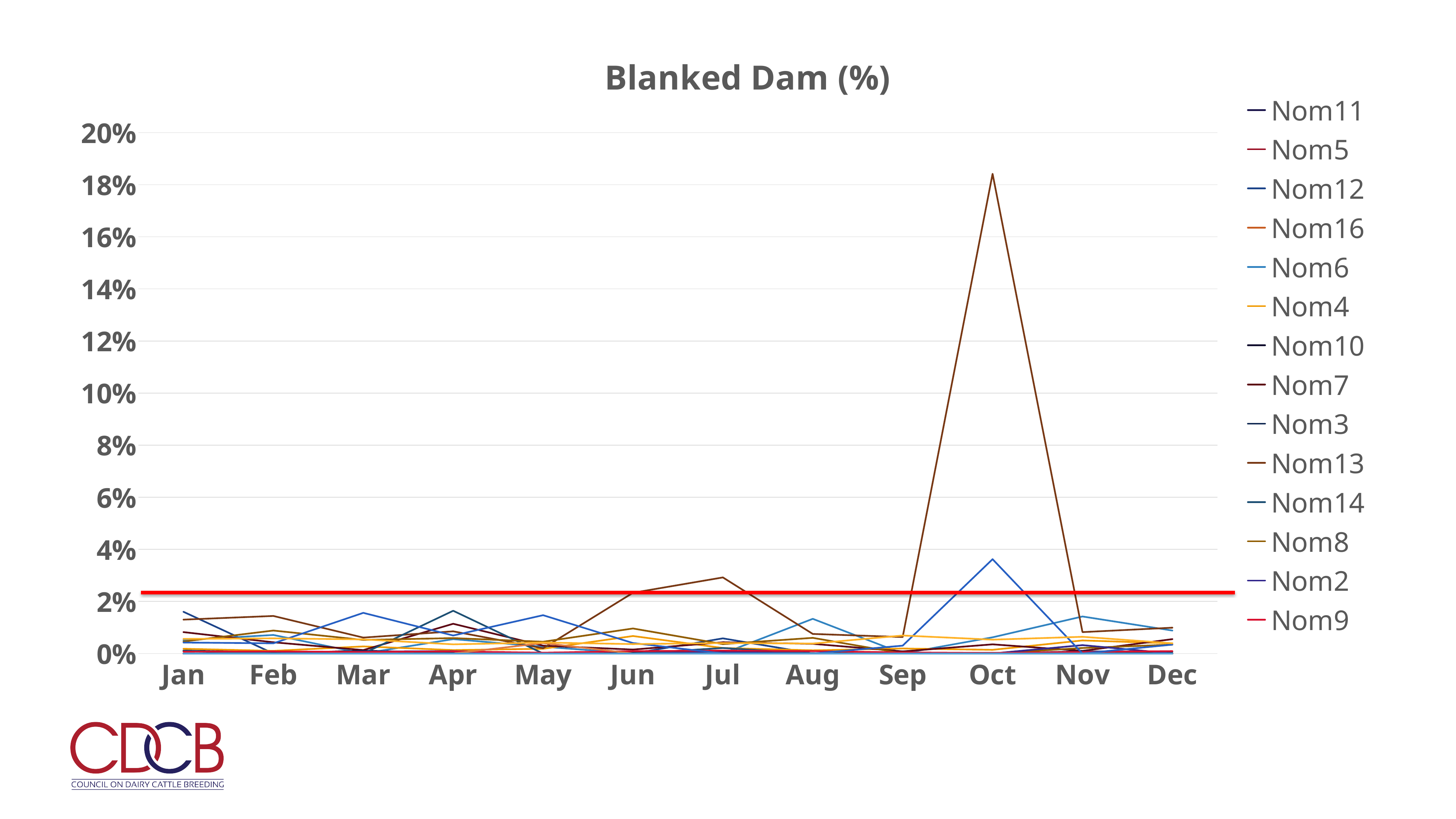
Which series is listed first in the legend? Nom11 Which series reaches the highest value on the chart? Nom13 How many series does the legend list? 14 How many months are shown along the x axis? 12 In Oct, which is larger, the value for Nom13 or the value for Nom12? Nom13 Is the value for Nom13 in Oct greater or less than 16%? greater In which month does Nom13 reach its highest value? Oct What kind of chart is shown on the slide? line chart Does the value for Nom13 rise or fall from Oct to Nov? fall What is the title of the chart? Blanked Dam (%)